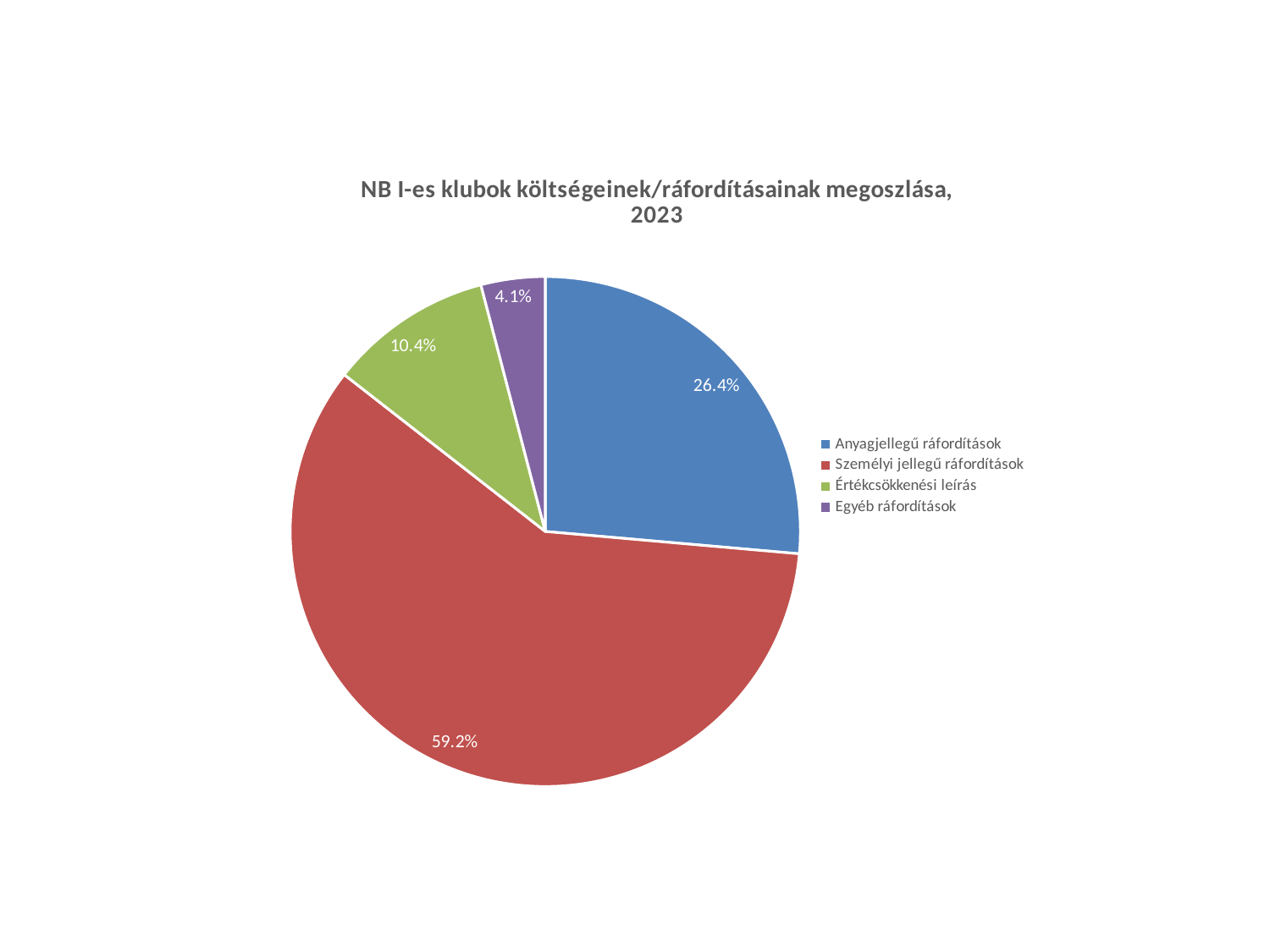
What is the difference in percentage points between Személyi jellegű ráfordítások and Anyagjellegű ráfordítások? 32.8 How many categories does the pie chart show? 4 What is the title of the chart? NB I-es klubok költségeinek/ráfordításainak megoszlása, 2023 What share of the pie is Egyéb ráfordítások? 4.1% What colour is the slice for Értékcsökkenési leírás? green Which is larger, Értékcsökkenési leírás or Egyéb ráfordítások? Értékcsökkenési leírás What share of the pie is Értékcsökkenési leírás? 10.4% What kind of chart is shown on the slide? pie chart What share of the pie is Személyi jellegű ráfordítások? 59.2% Which category has the largest slice of the pie? Személyi jellegű ráfordítások Which category has the smallest slice of the pie? Egyéb ráfordítások